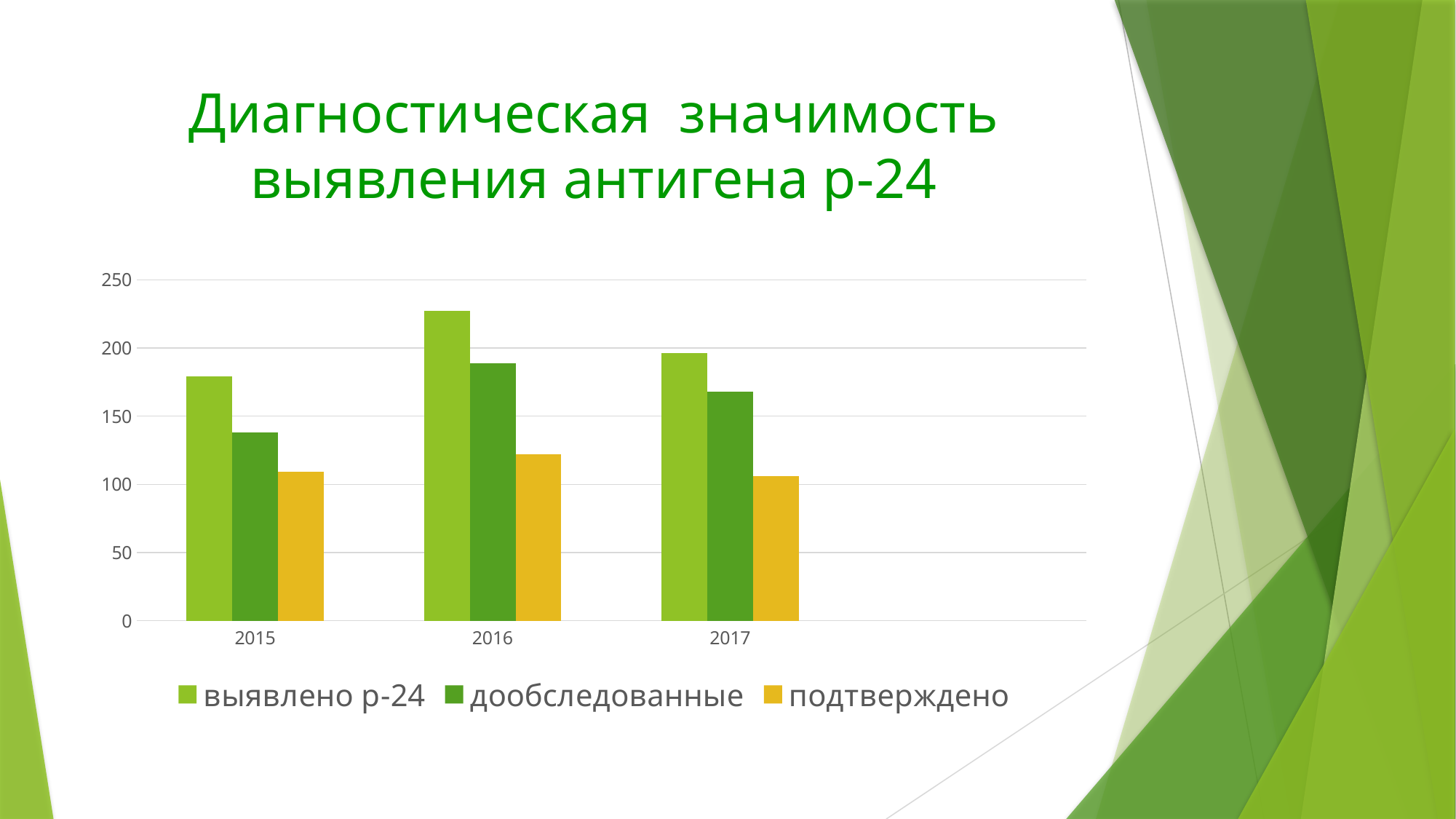
Which is larger: дообследованные in 2016 or дообследованные in 2017? 2016 Which year has the highest value for выявлено р-24? 2016 Is the value for выявлено р-24 in 2016 greater or less than 200? greater Is the value for выявлено р-24 in 2015 greater or less than 200? less How many series does the chart legend list? 3 Which series in the legend is shown in yellow? подтверждено How many years are shown on the x axis of the chart? 3 Is the value for подтверждено in 2016 greater or less than 150? less Which year has the lowest value for выявлено р-24? 2015 What kind of chart is shown on the slide? bar chart